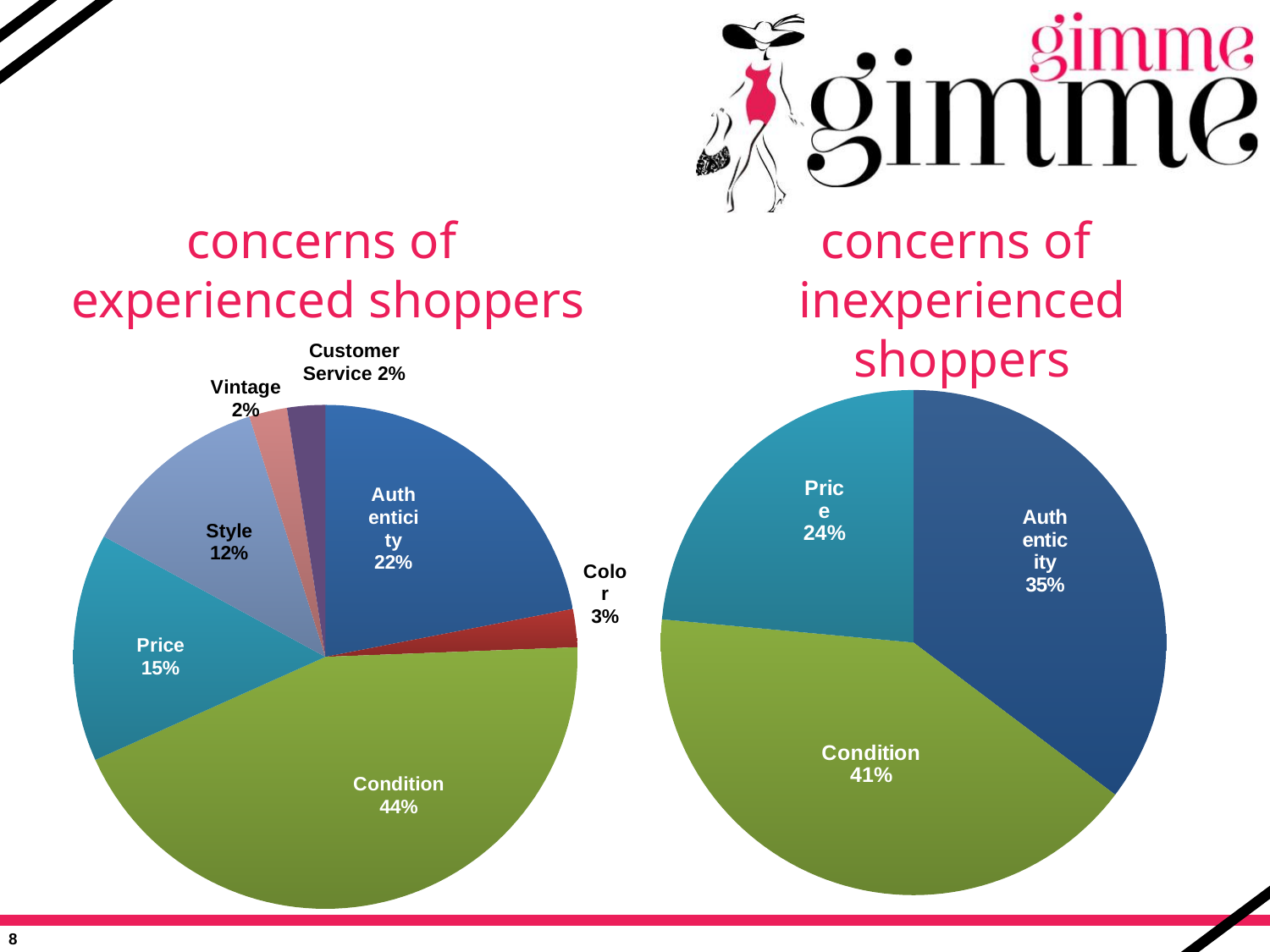
In the 'concerns of experienced shoppers' chart, what is the difference between Condition and Authenticity? 22% In the 'concerns of experienced shoppers' chart, what percentage is Style? 12% What type of chart is the 'concerns of inexperienced shoppers' chart? Pie chart In the 'concerns of experienced shoppers' chart, what percentage is Condition? 44% In the 'concerns of experienced shoppers' chart, what percentage is Customer Service? 2% How many categories are shown in the 'concerns of inexperienced shoppers' chart? 3 How many categories are shown in the 'concerns of experienced shoppers' chart? 7 In the 'concerns of inexperienced shoppers' chart, what percentage is Authenticity? 35% In the 'concerns of experienced shoppers' chart, which category has the largest share? Condition In the 'concerns of inexperienced shoppers' chart, what is the difference between Condition and Price? 17% In the 'concerns of inexperienced shoppers' chart, which category has the smallest share? Price In the 'concerns of experienced shoppers' chart, which is larger, Price or Style? Price